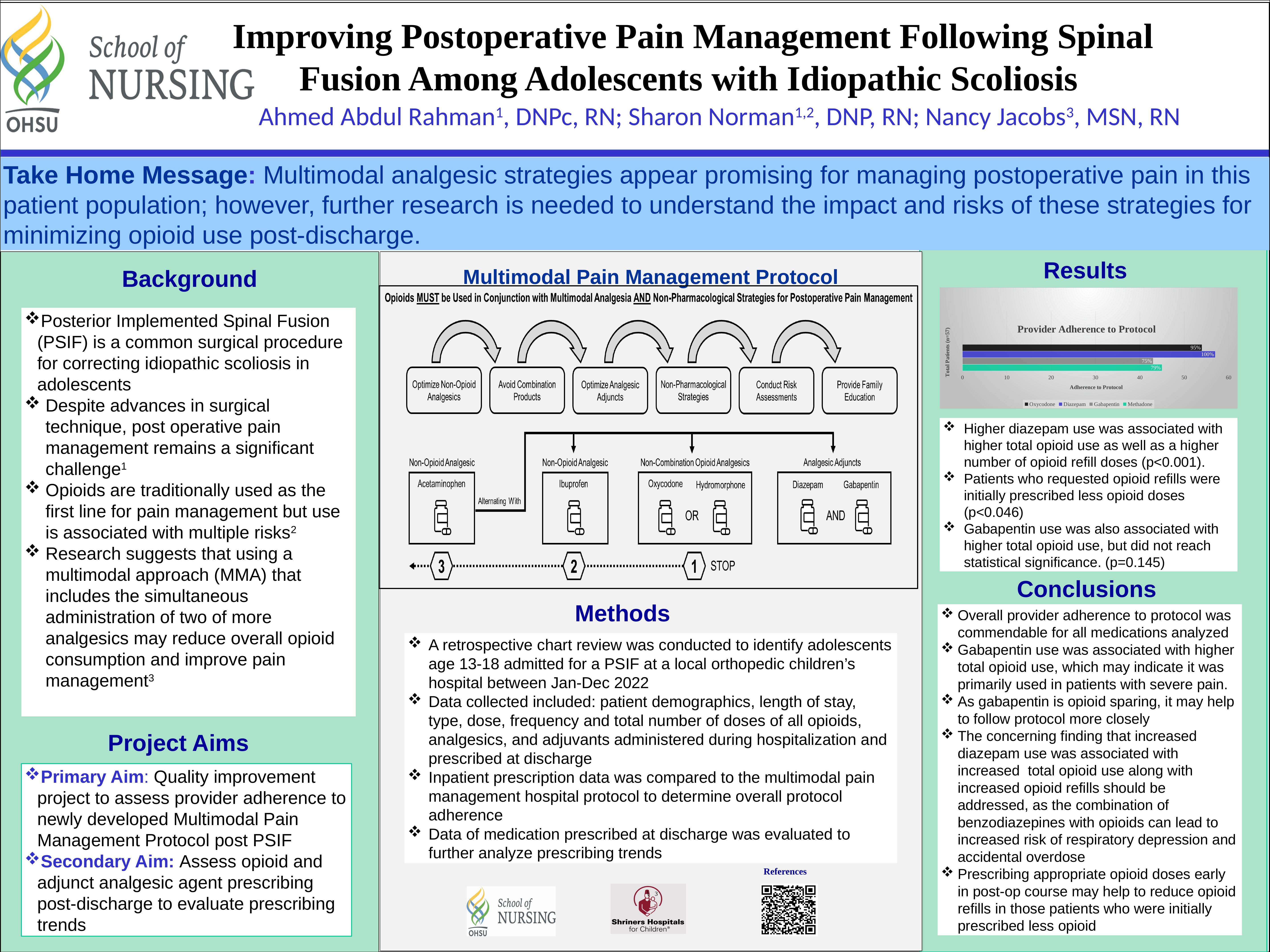
In the Provider Adherence to Protocol chart, is the adherence for Oxycodone or Methadone higher? Oxycodone What kind of chart is the Provider Adherence to Protocol chart? bar chart In the Provider Adherence to Protocol chart, what is the difference between the Diazepam and Oxycodone adherence percentages? 5% How many series does the legend of the Provider Adherence to Protocol chart list? 4 What is the title of the chart in the Results section? Provider Adherence to Protocol In the Provider Adherence to Protocol chart, what is the data label for Methadone? 79% In the Provider Adherence to Protocol chart, what is the data label for Gabapentin? 75% In the Provider Adherence to Protocol chart, what is the data label for Oxycodone? 95% In the Provider Adherence to Protocol chart, which medication has the lowest adherence? Gabapentin In the Provider Adherence to Protocol chart, which medication has the highest adherence? Diazepam In the Provider Adherence to Protocol chart, what is the data label for Diazepam? 100% In the Provider Adherence to Protocol chart, is the bar for Gabapentin greater or less than 50 on the Adherence to Protocol axis? less